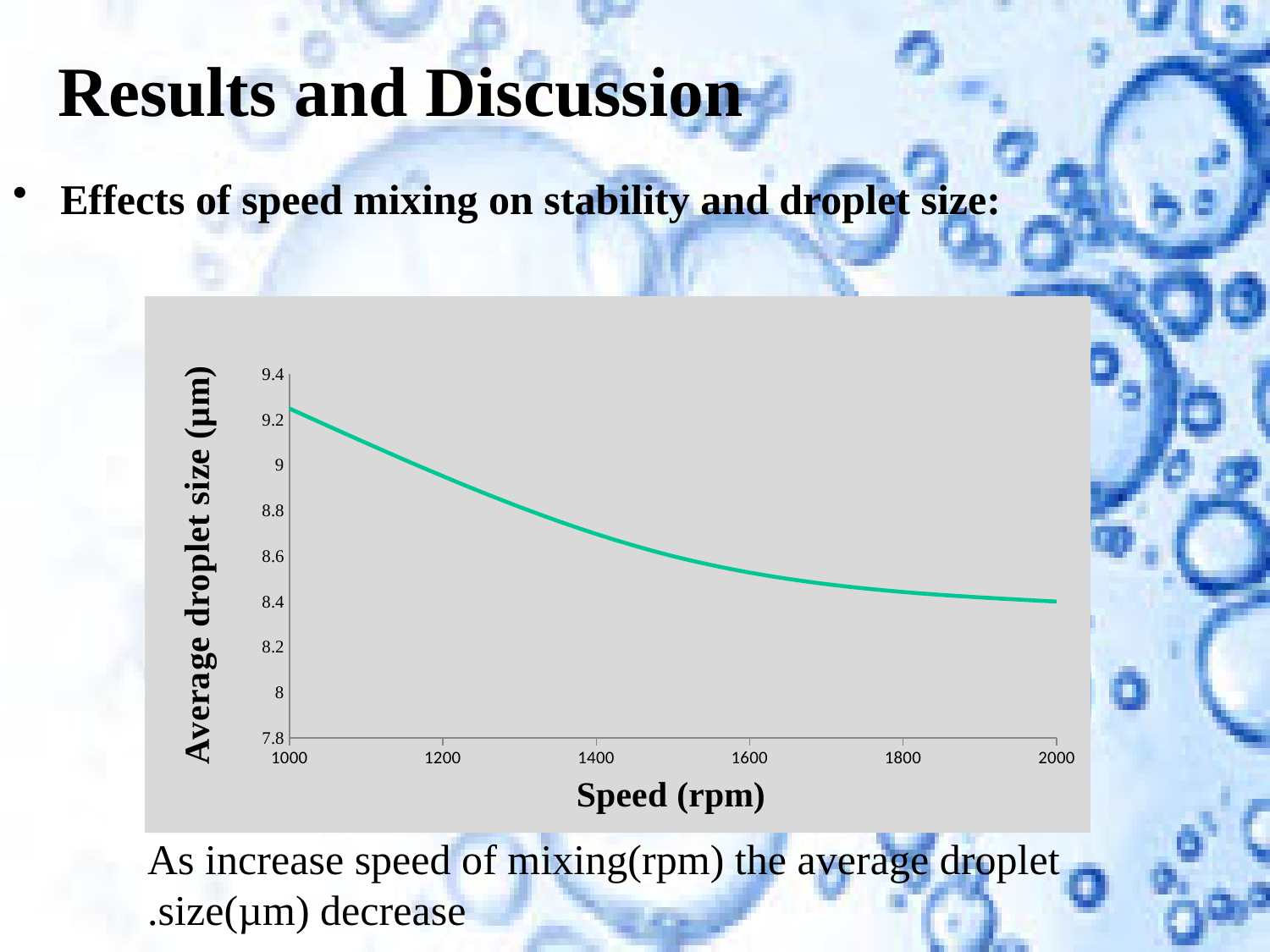
Is the average droplet size at 1800 rpm greater or less than 8.6? less Is the average droplet size at 1200 rpm greater or less than 8.8? greater Is the average droplet size at 1600 rpm greater or less than 8.8? less Which is larger, the average droplet size at 1000 rpm or at 2000 rpm? 1000 rpm At which speed is the average droplet size highest? 1000 rpm As speed (rpm) increases along the x axis, does the average droplet size rise or fall? fall What is the label of the x axis? Speed (rpm) What kind of chart is shown on the slide? line chart What is the label of the y axis? Average droplet size (µm) At which speed is the average droplet size lowest? 2000 rpm